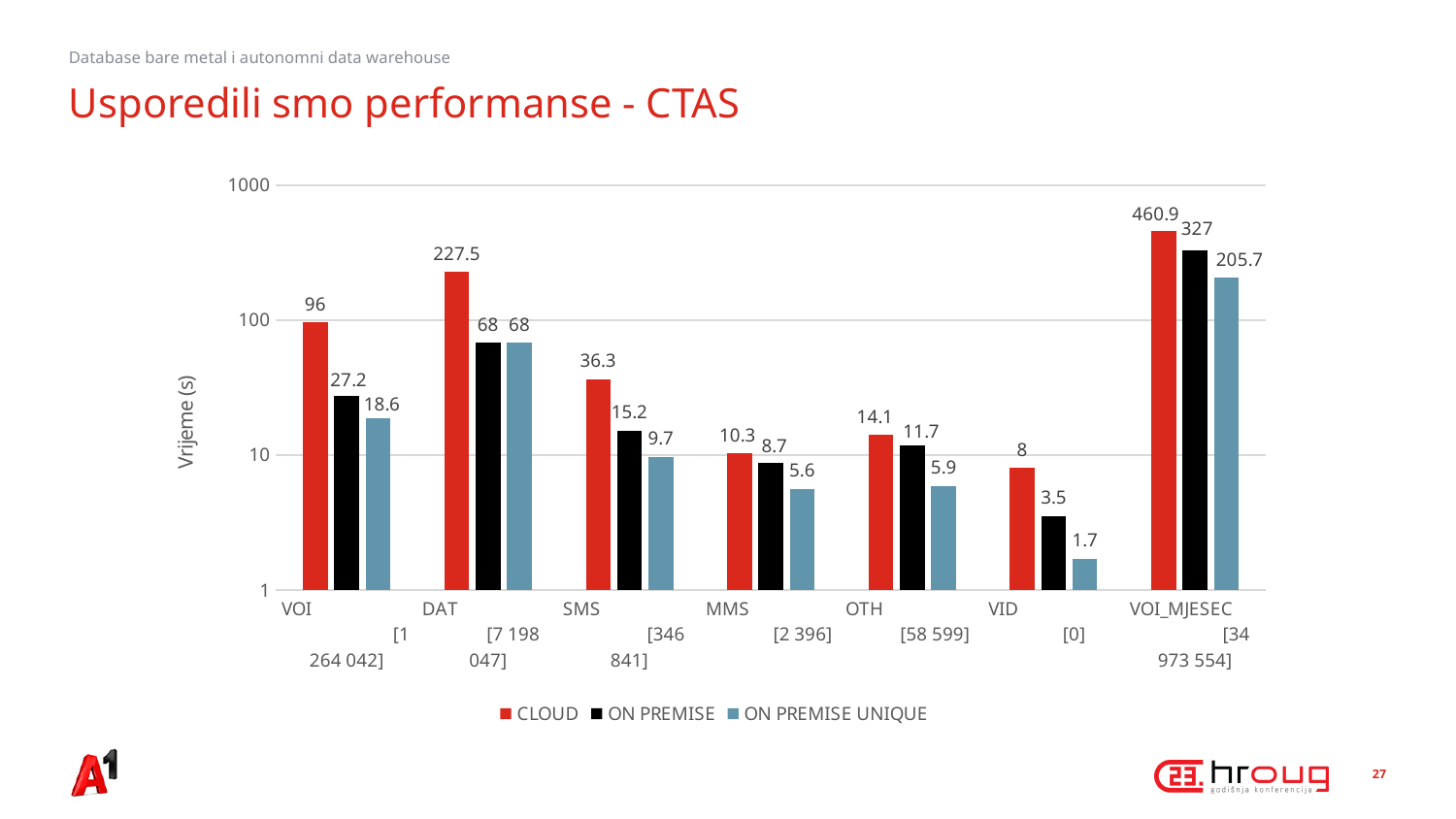
What is the difference between the CLOUD and ON PREMISE values for VOI? 68.8 Which category has the highest CLOUD value? VOI_MJESEC What is the CLOUD value for DAT? 227.5 What is the label of the y axis? Vrijeme (s) What is the ON PREMISE value for VOI_MJESEC? 327 How many series does the legend list? 3 Which is larger for SMS, the CLOUD value or the ON PREMISE value? CLOUD Which category has the lowest ON PREMISE UNIQUE value? VID What type of chart is shown on the slide? bar chart What is the ON PREMISE UNIQUE value for VID? 1.7 What colour are the CLOUD bars? red How many categories are shown on the x axis? 7